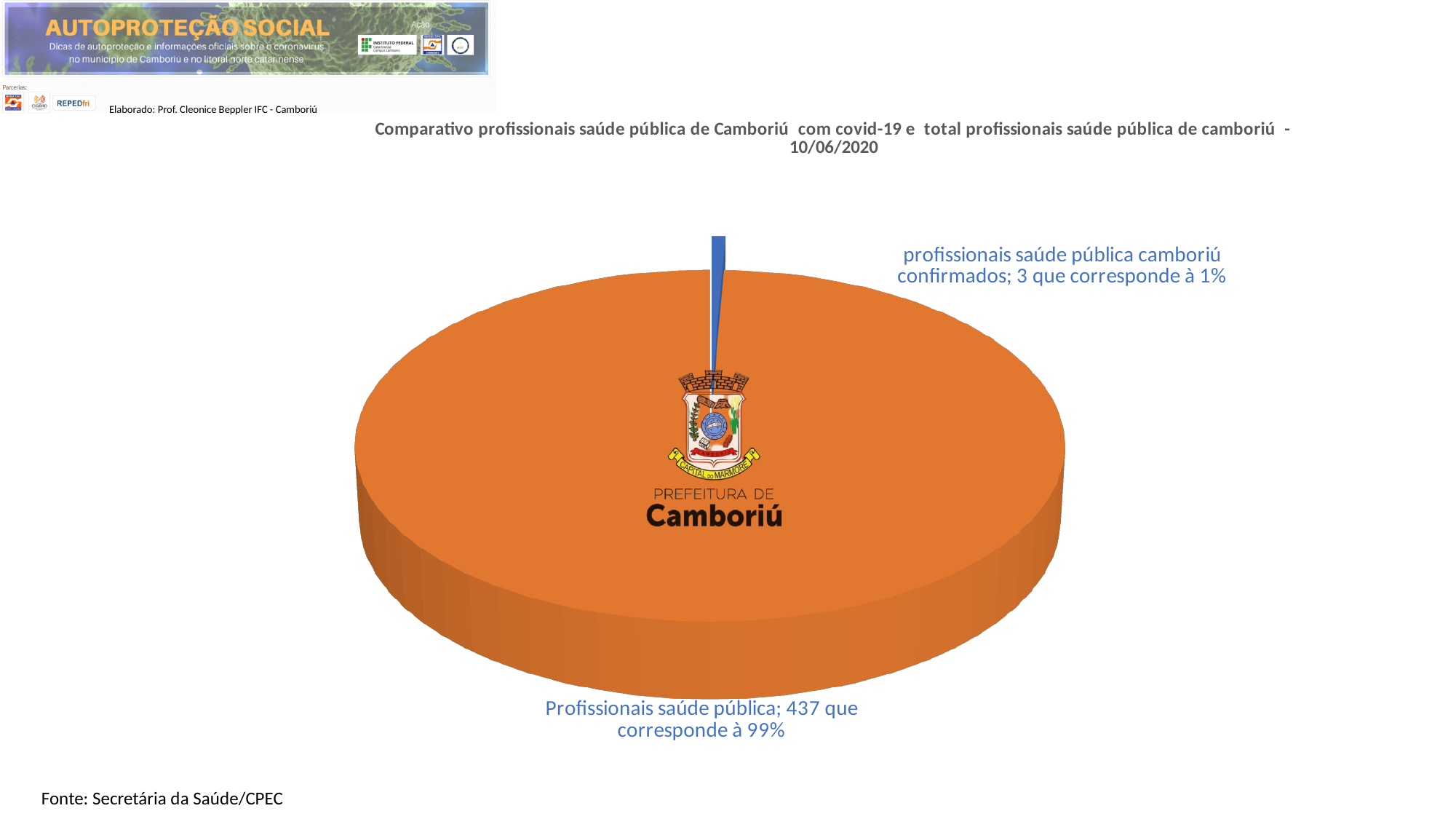
What share of the pie does "Profissionais saúde pública" represent? 99% What colour is the slice for "profissionais saúde pública camboriú confirmados"? Blue What kind of chart is shown on the slide? Pie chart What is the value shown for "Profissionais saúde pública"? 437 What is the value shown for "profissionais saúde pública camboriú confirmados"? 3 What share of the pie does "profissionais saúde pública camboriú confirmados" represent? 1% What date appears in the chart title? 10/06/2020 Which is larger: the value for "Profissionais saúde pública" or the value for "profissionais saúde pública camboriú confirmados"? Profissionais saúde pública Which slice of the pie chart is the largest? Profissionais saúde pública Which slice of the pie chart is the smallest? profissionais saúde pública camboriú confirmados What is the difference between the value for "Profissionais saúde pública" and the value for "profissionais saúde pública camboriú confirmados"? 434 How many slices does the pie chart have? 2